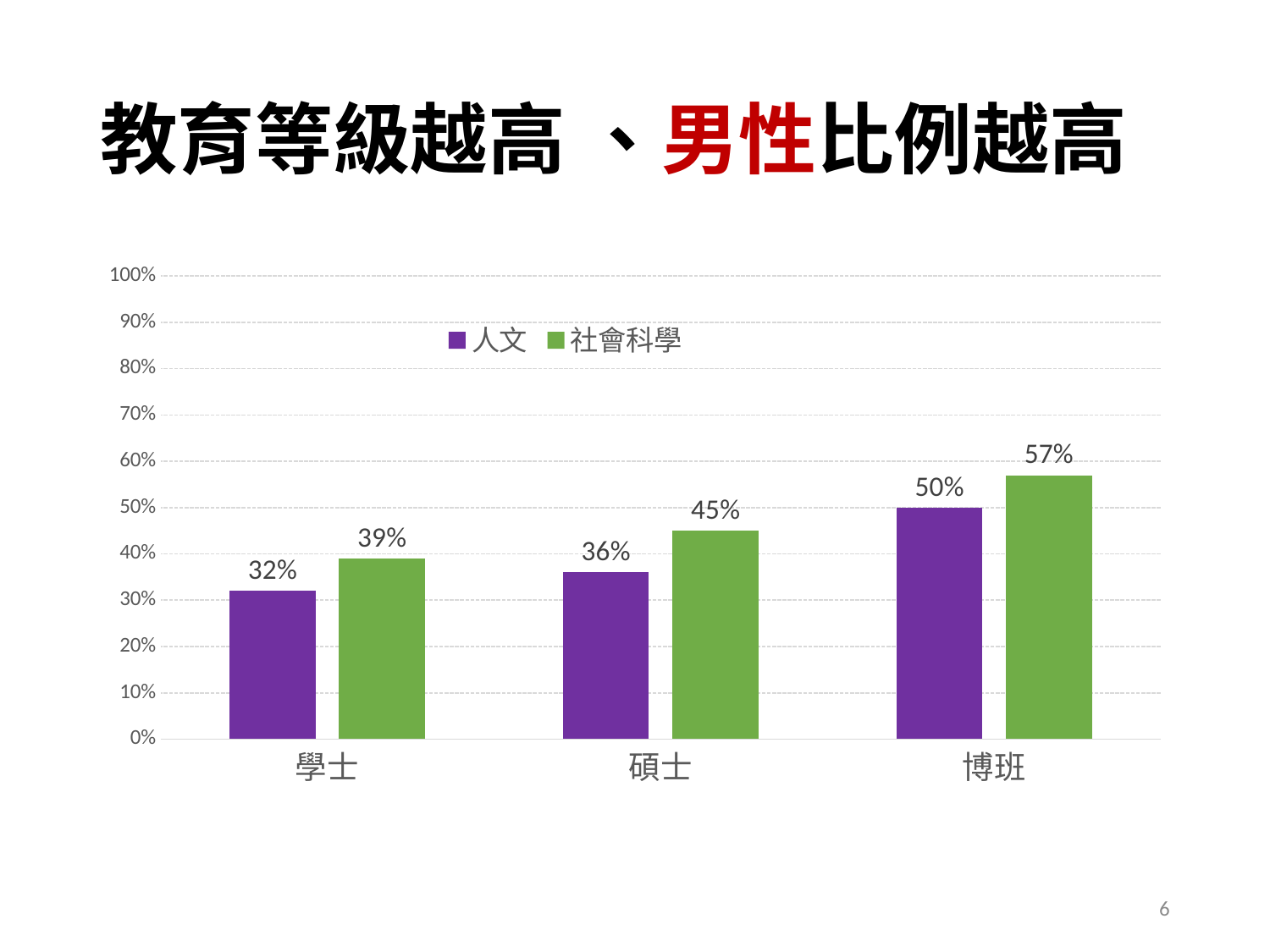
How many categories are shown on the x axis? 3 How many series does the legend list? 2 What kind of chart is shown on the slide? bar chart Is the value for 人文 at 博班 greater or less than 40%? greater Which is larger at 博班, 人文 or 社會科學? 社會科學 Which category has the lowest value for 人文? 學士 What is the value for 人文 at 學士? 32% Which category has the highest value for 社會科學? 博班 Do the values for 人文 rise or fall from 學士 to 博班? rise What is the value for 人文 at 碩士? 36% What is the difference between 社會科學 and 人文 at 碩士? 9% What is the value for 社會科學 at 博班? 57%